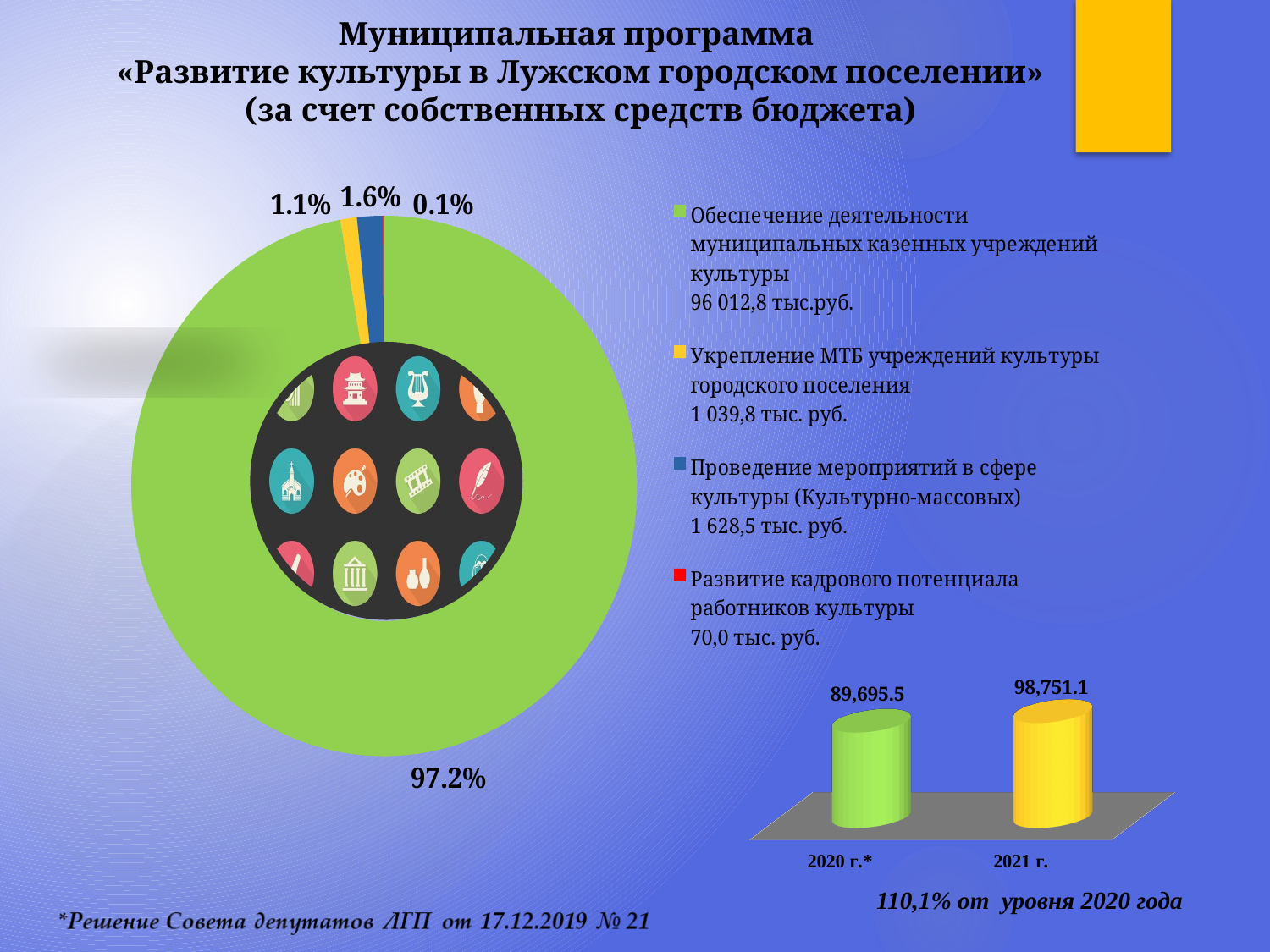
In the pie chart on the left, what share does the yellow slice (Укрепление МТБ учреждений культуры) have? 1.1% In the pie chart on the left, which category has the smallest share? Развитие кадрового потенциала работников культуры What kind of chart is the chart on the left side of the slide? doughnut chart In the bar chart in the bottom right, what is the value for 2021 г.? 98,751.1 In the pie chart on the left, what share does the green slice (Обеспечение деятельности муниципальных казенных учреждений культуры) have? 97.2% In the pie chart on the left, which category has the largest share? Обеспечение деятельности муниципальных казенных учреждений культуры In the pie chart on the left, what share does the blue slice (Проведение мероприятий в сфере культуры) have? 1.6% In the bar chart in the bottom right, what is the difference between the 2021 г. value and the 2020 г.* value? 9,055.6 In the bar chart in the bottom right, what is the value for 2020 г.*? 89,695.5 How many categories does the legend of the pie chart on the left list? 4 According to the legend of the pie chart on the left, what is the amount for Укрепление МТБ учреждений культуры городского поселения? 1 039,8 тыс. руб. What kind of chart is the chart in the bottom right of the slide? bar chart